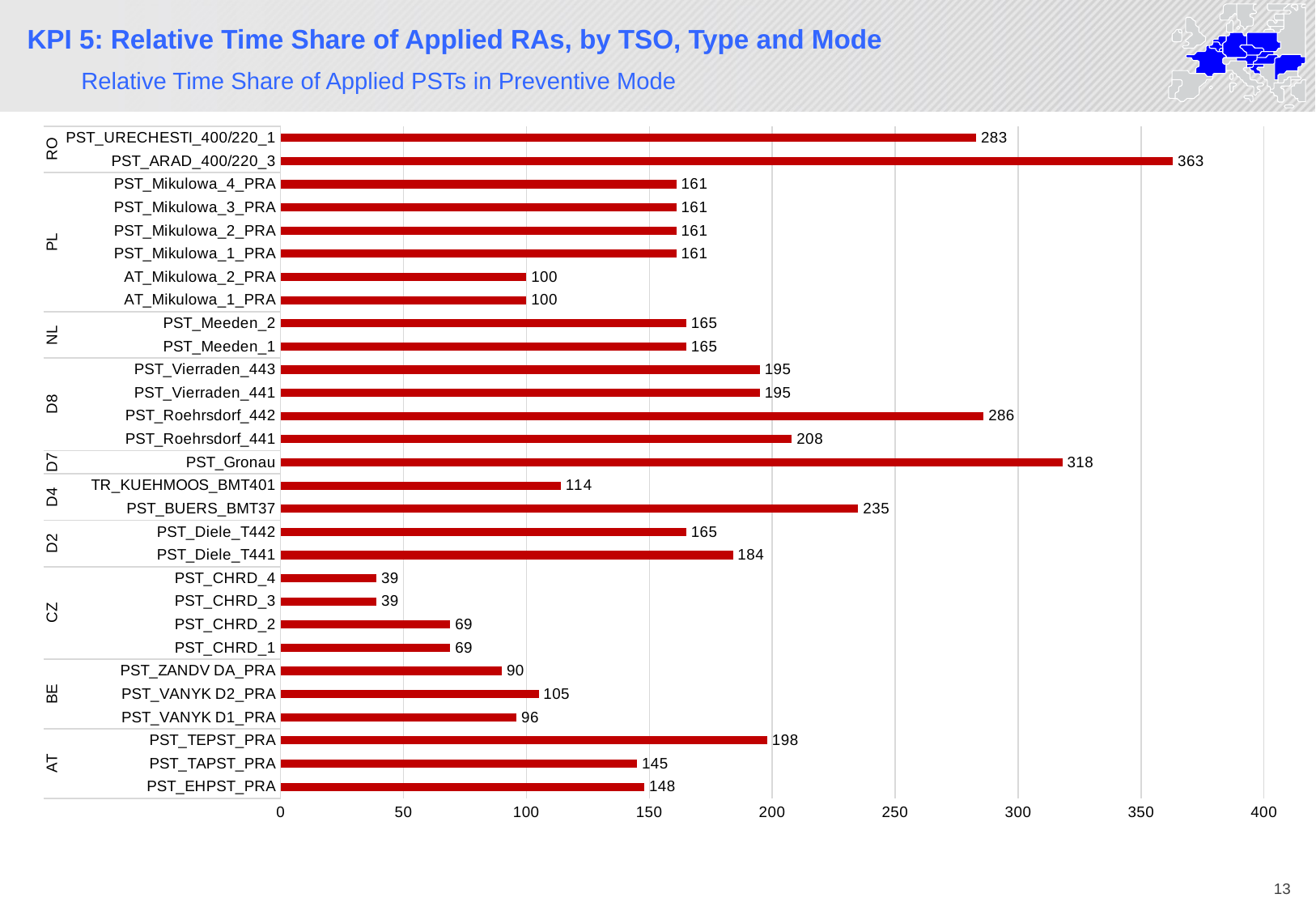
What is the subtitle of the chart? Relative Time Share of Applied PSTs in Preventive Mode How many bars are shown on the chart? 29 Which is larger, the value for PST_BUERS_BMT37 or the value for PST_Diele_T441? PST_BUERS_BMT37 What is the value for TR_KUEHMOOS_BMT401? 114 What is the lowest value shown on the chart? 39 What is the value for PST_Gronau? 318 What is the difference between the values for PST_Roehrsdorf_442 and PST_Roehrsdorf_441? 78 What is the value for PST_ARAD_400/220_3? 363 What kind of chart is shown on the slide? bar chart Is the value for PST_URECHESTI_400/220_1 greater or less than 250? greater What is the value for PST_ZANDV DA_PRA? 90 Which category has the highest value? PST_ARAD_400/220_3